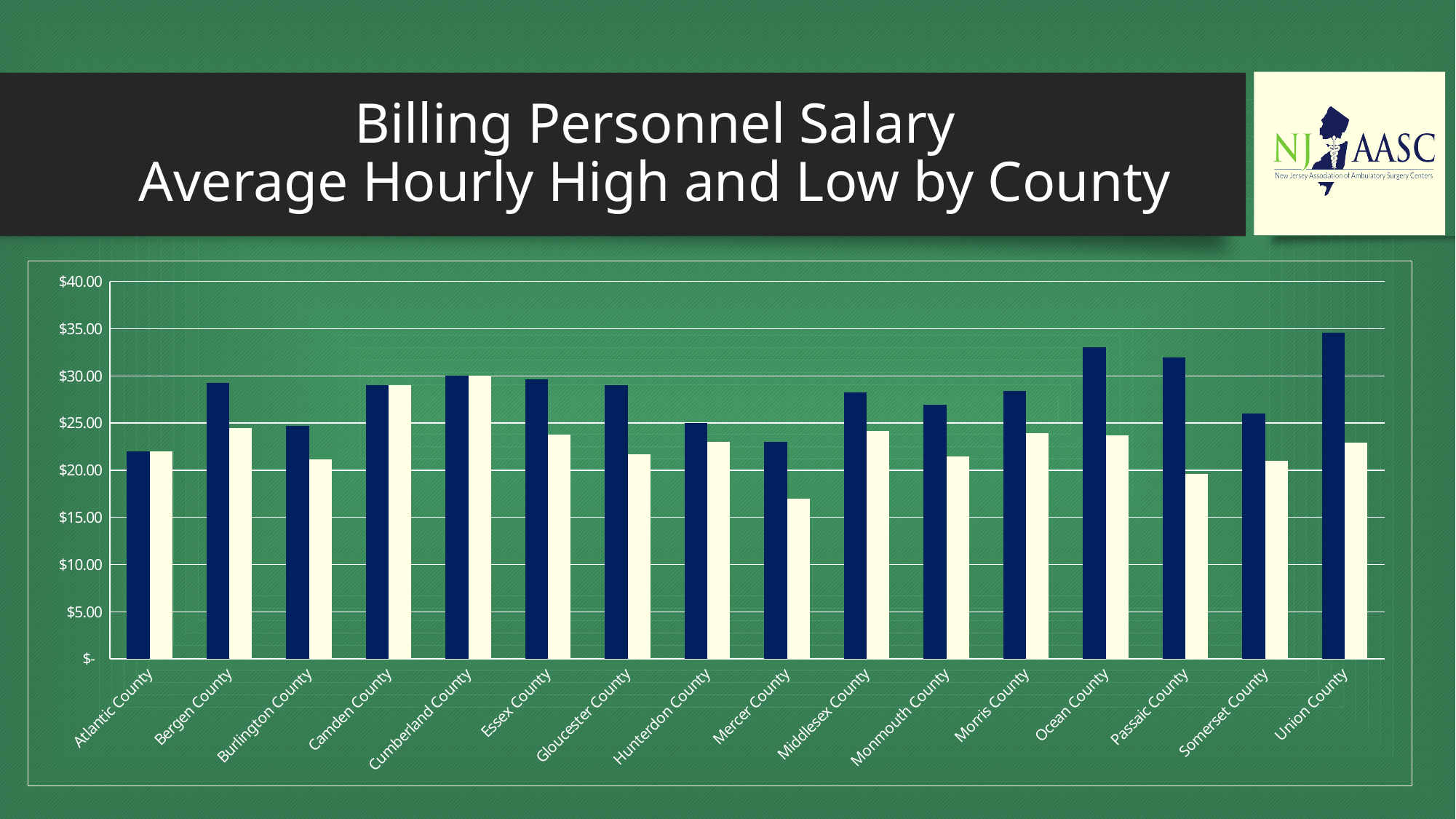
Is the dark blue bar for Union County greater or less than $30.00? greater Is the cream-coloured bar for Mercer County greater or less than $20.00? less What is the title of the slide's chart? Billing Personnel Salary Average Hourly High and Low by County Which county has the tallest dark blue bar? Union County Which county has the shortest cream-coloured bar? Mercer County Is the cream-coloured bar for Cumberland County greater or less than $25.00? greater Which is larger: the cream-coloured bar for Hunterdon County or the cream-coloured bar for Mercer County? Hunterdon County How many counties are shown on the x axis of the chart? 16 What is the highest value shown on the y axis of the chart? $40.00 How many bars are plotted for each county? 2 What kind of chart is shown on the slide? Bar chart